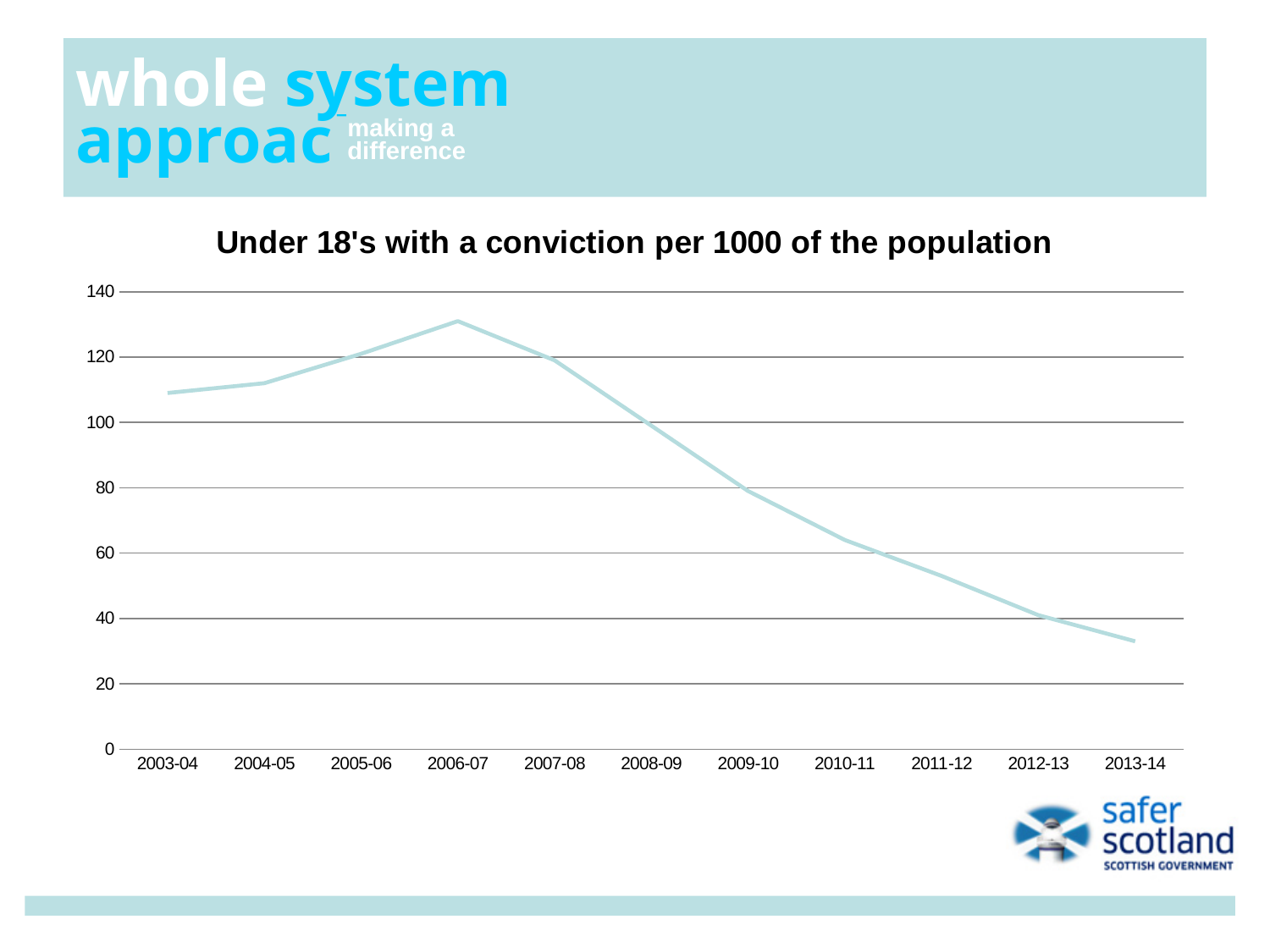
Which year has the larger value, 2003-04 or 2013-14? 2003-04 How many years are plotted along the x axis? 11 Which year has the larger value, 2006-07 or 2009-10? 2006-07 In which year is the value lowest? 2013-14 Is the value for 2003-04 greater or less than 100? greater Do the values rise or fall from 2006-07 to 2013-14? fall In which year is the value highest? 2006-07 What is the title of the chart? Under 18's with a conviction per 1000 of the population Is the value for 2011-12 greater or less than 60? less Is the value for 2006-07 greater or less than 120? greater What kind of chart is shown on the slide? line chart